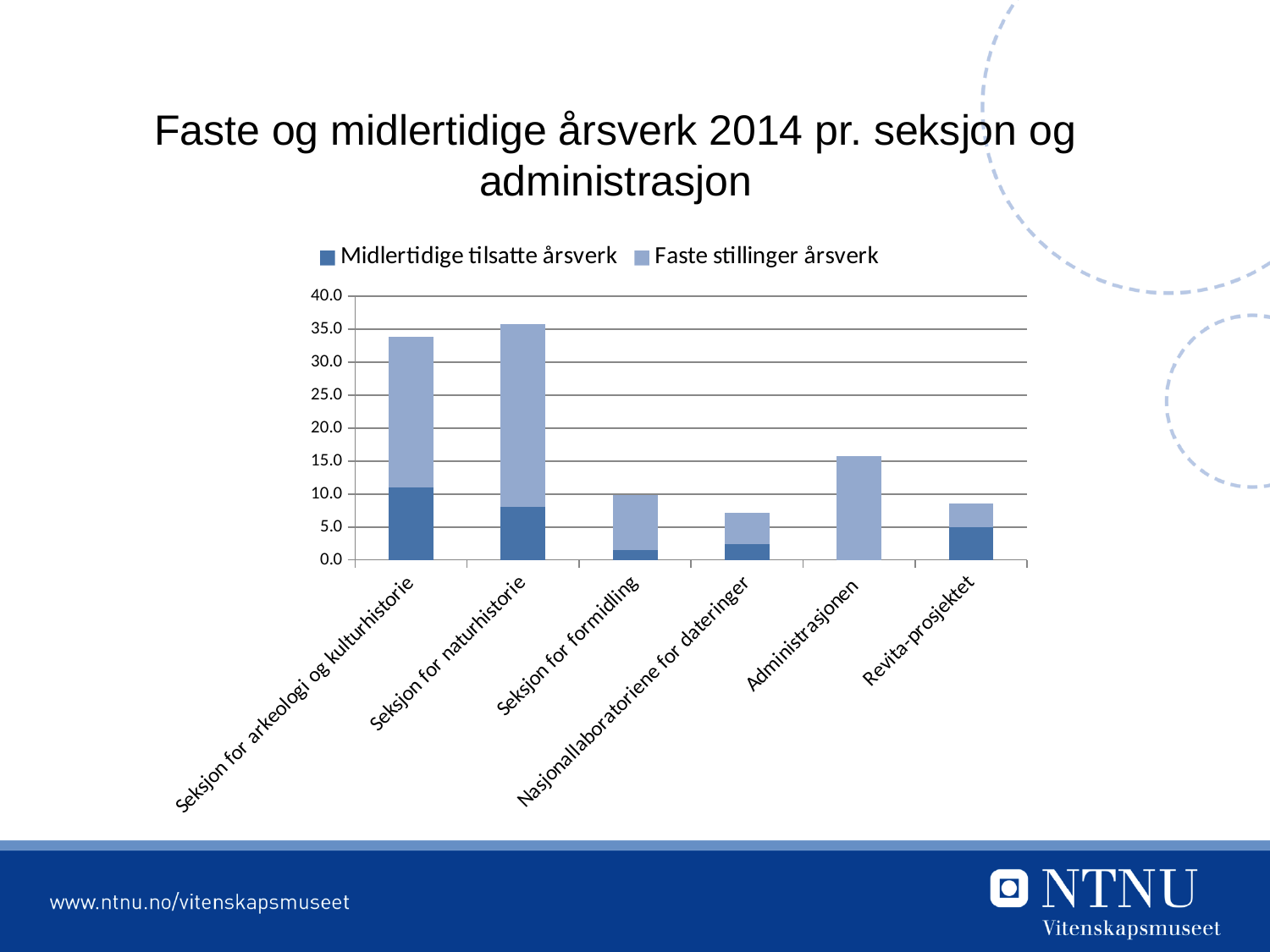
What kind of chart is shown on the slide? Stacked bar chart How many series does the chart's legend list? 2 Is the total bar height for Seksjon for formidling greater or less than 15.0? less Is the total bar height for Seksjon for arkeologi og kulturhistorie greater or less than 30.0? greater What are the two series named in the chart's legend? Midlertidige tilsatte årsverk and Faste stillinger årsverk Which category has the larger Midlertidige tilsatte årsverk segment, Seksjon for arkeologi og kulturhistorie or Seksjon for naturhistorie? Seksjon for arkeologi og kulturhistorie How many categories are shown along the x axis of the chart? 6 Which category has the tallest stacked bar in the chart? Seksjon for naturhistorie Is the total bar height for Administrasjonen greater or less than 20.0? less Which category shows no Midlertidige tilsatte årsverk segment at all? Administrasjonen Which has the taller stacked bar, Administrasjonen or Revita-prosjektet? Administrasjonen